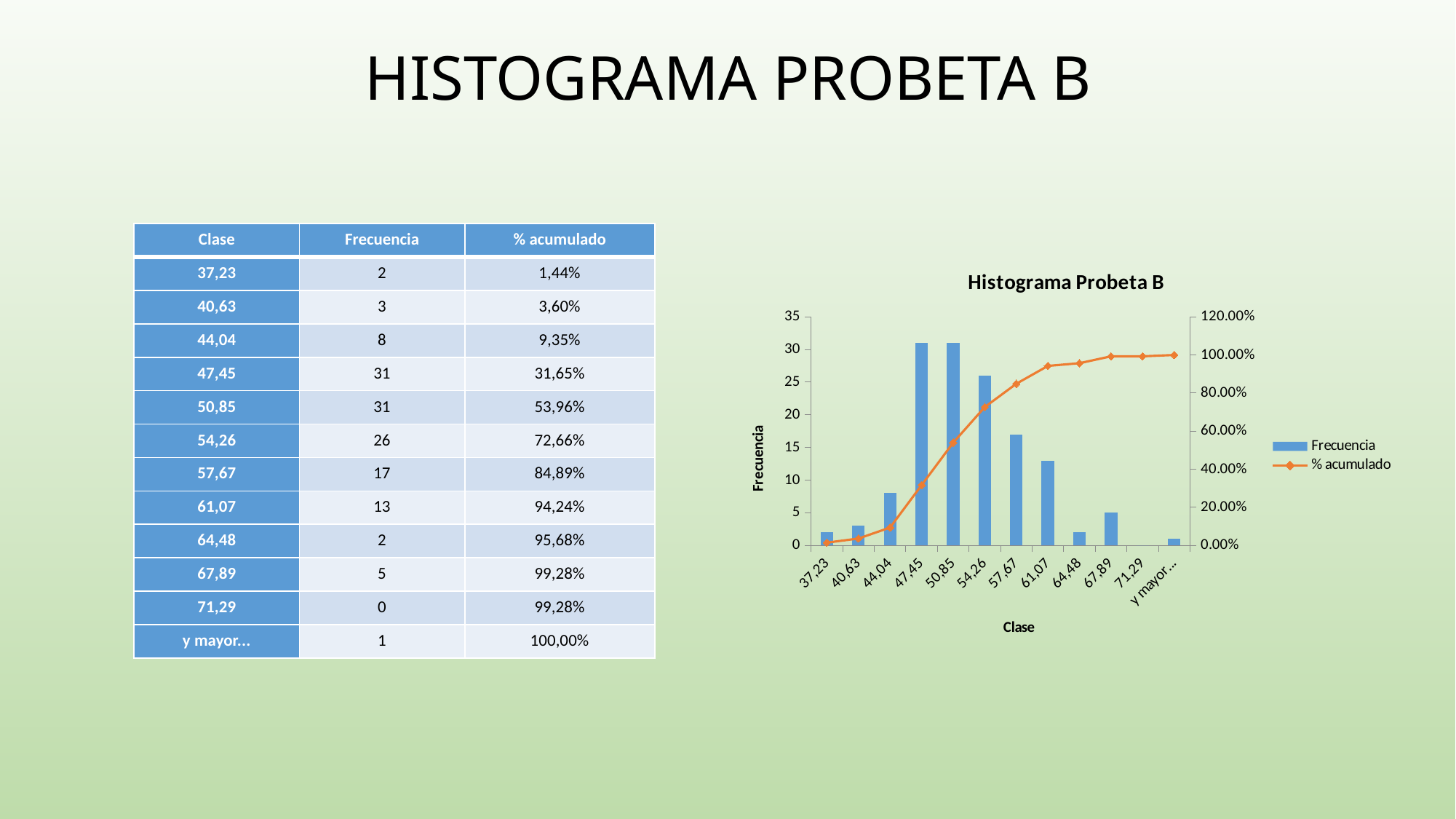
How many classes (categories) are plotted along the x axis of the chart? 12 What is the % acumulado for class 57,67? 84,89% Is the Frecuencia for class 44,04 greater or less than 10? less Is the Frecuencia for class 61,07 greater or less than 10? greater What is the title of the chart? Histograma Probeta B What is the Frecuencia for class 54,26? 26 Does the % acumulado line rise or fall from left to right along the x axis? It rises Which class has the larger Frecuencia, 57,67 or 61,07? 57,67 What kind of chart is shown on the slide? A bar chart combined with a line How many series does the chart legend list? 2 Which class has the lowest Frecuencia in the chart? 71,29 What is the difference in Frecuencia between class 54,26 and class 57,67? 9